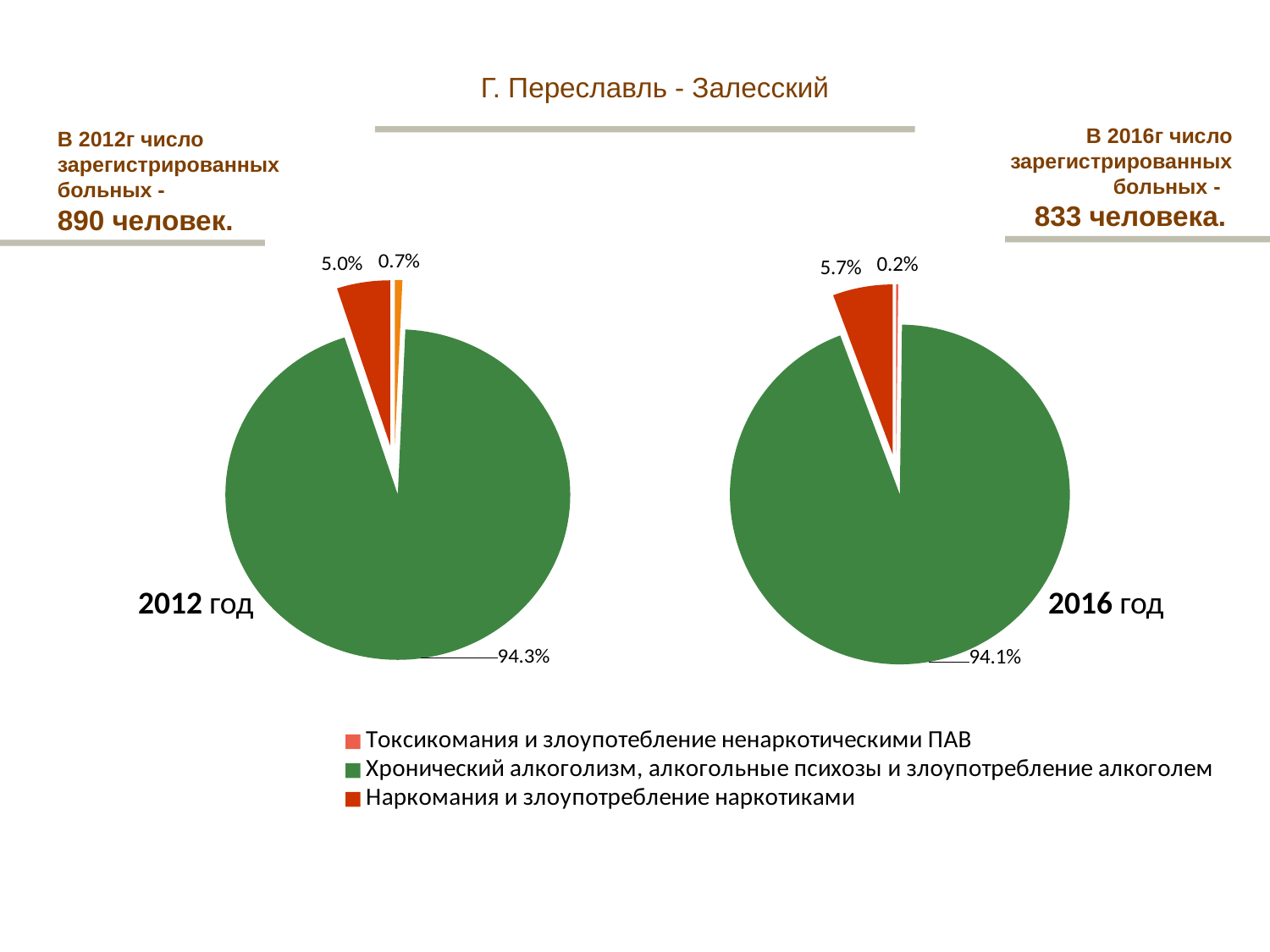
In the 2012 год pie chart, what share is labelled for Токсикомания и злоупотебление ненаркотическими ПАВ? 0.7% In the 2012 год pie chart, which category has the largest slice? Хронический алкоголизм, алкогольные психозы и злоупотребление алкоголем Which is larger: the share for Наркомания и злоупотребление наркотиками in the 2012 год chart or in the 2016 год chart? 2016 год In the 2016 год pie chart, what share is labelled for Токсикомания и злоупотебление ненаркотическими ПАВ? 0.2% In the 2016 год pie chart, what share is labelled for Наркомания и злоупотребление наркотиками? 5.7% How many categories does the legend list? 3 In the 2016 год pie chart, what share is labelled for Хронический алкоголизм, алкогольные психозы и злоупотребление алкоголем? 94.1% In the 2012 год pie chart, what share is labelled for the largest slice (Хронический алкоголизм, алкогольные психозы и злоупотребление алкоголем)? 94.3% In the 2012 год pie chart, what share is labelled for Наркомания и злоупотребление наркотиками? 5.0% What is the difference between the Наркомания и злоупотребление наркотиками share in the 2016 год chart and in the 2012 год chart? 0.7% What kind of charts are shown on the slide? Pie charts In the 2016 год pie chart, which category has the smallest slice? Токсикомания и злоупотебление ненаркотическими ПАВ